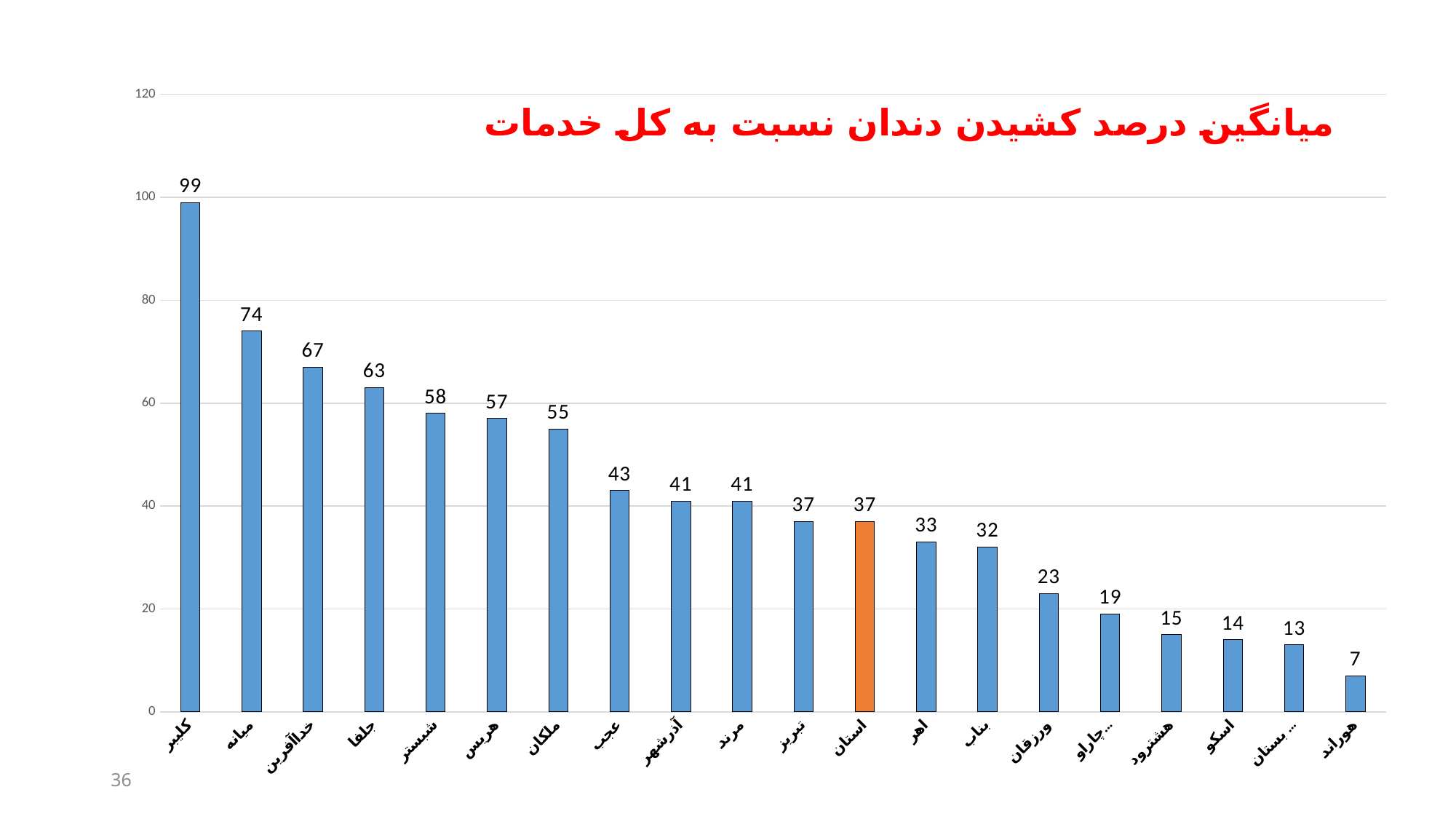
What is the value for استان? 37 What is the difference between the values for میانه and جلفا? 11 Which bar is coloured orange instead of blue? استان How many bars are plotted in the chart? 20 What is the value for هوراند? 7 Which is larger, the value for اهر or the value for ورزقان? اهر Do the values rise or fall moving from left to right along the x axis? fall Which category has the lowest value? هوراند What type of chart is shown on the slide? bar chart What is the value for ملکان? 55 What is the value for کلیبر? 99 Which category has the highest value? کلیبر